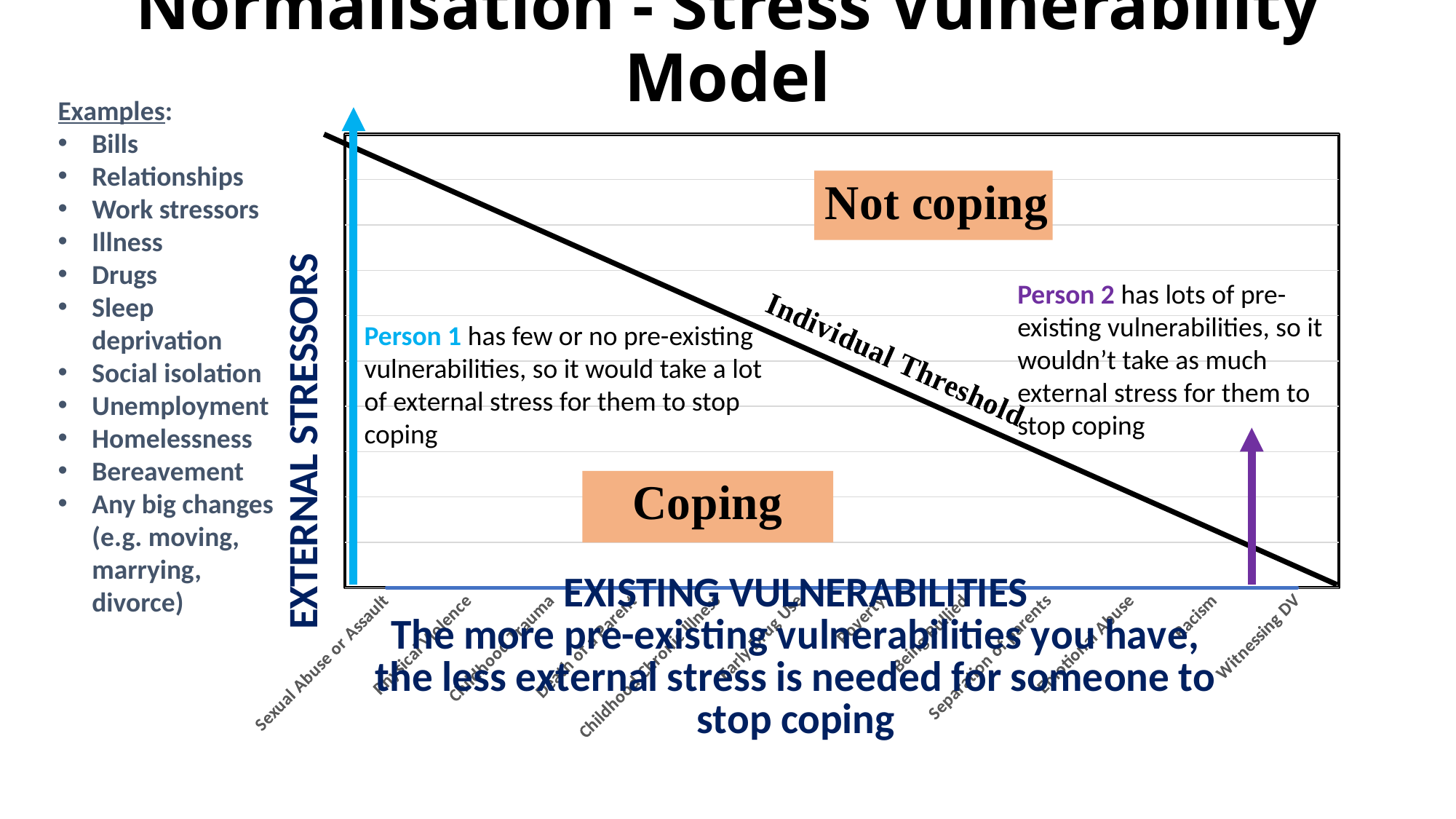
Does the Individual Threshold line rise or fall as you move from left to right along the x axis? fall What is the diagonal line on the chart labelled? Individual Threshold How many categories are listed along the x axis of the chart? 12 What is the label on the vertical axis of the chart? EXTERNAL STRESSORS What kind of chart is shown on the slide? line chart